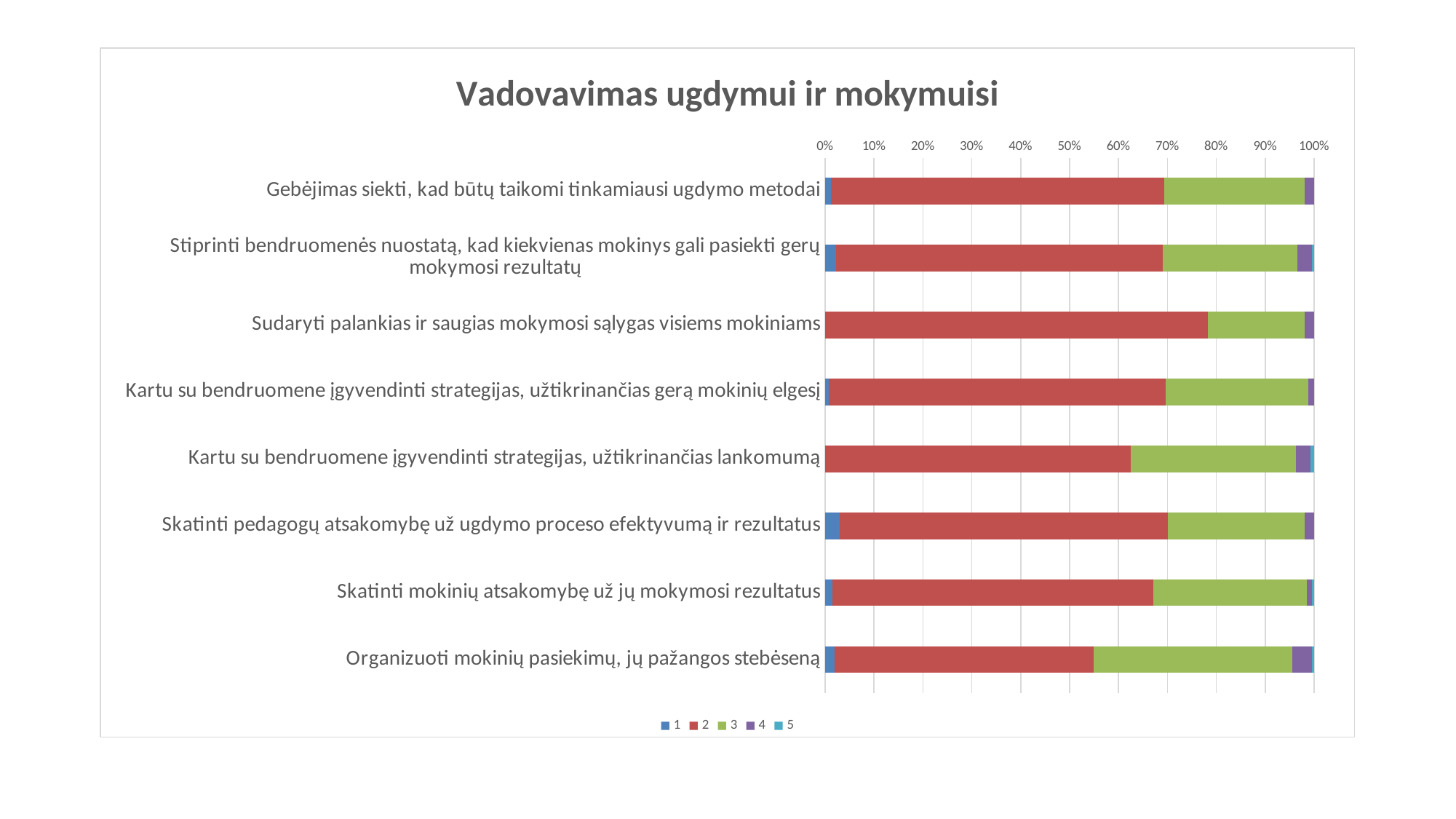
What is the total each stacked bar reaches on the axis? 100% Is the share of series 3 for 'Organizuoti mokinių pasiekimų, jų pažangos stebėseną' greater or less than 30%? greater What is the title of the chart? Vadovavimas ugdymui ir mokymuisi Which category has the largest share for series 2? Sudaryti palankias ir saugias mokymosi sąlygas visiems mokiniams Is the share of series 2 for 'Sudaryti palankias ir saugias mokymosi sąlygas visiems mokiniams' greater or less than 70%? greater How many categories are plotted on the chart? 8 How many series does the legend list? 5 What kind of chart is shown on the slide? Stacked bar chart Is the share of series 2 for 'Organizuoti mokinių pasiekimų, jų pažangos stebėseną' greater or less than 60%? less Which category has the smallest share for series 2? Organizuoti mokinių pasiekimų, jų pažangos stebėseną What are the legend entries of the chart? 1, 2, 3, 4, 5 Which category has a larger share for series 3: 'Organizuoti mokinių pasiekimų, jų pažangos stebėseną' or 'Sudaryti palankias ir saugias mokymosi sąlygas visiems mokiniams'? Organizuoti mokinių pasiekimų, jų pažangos stebėseną